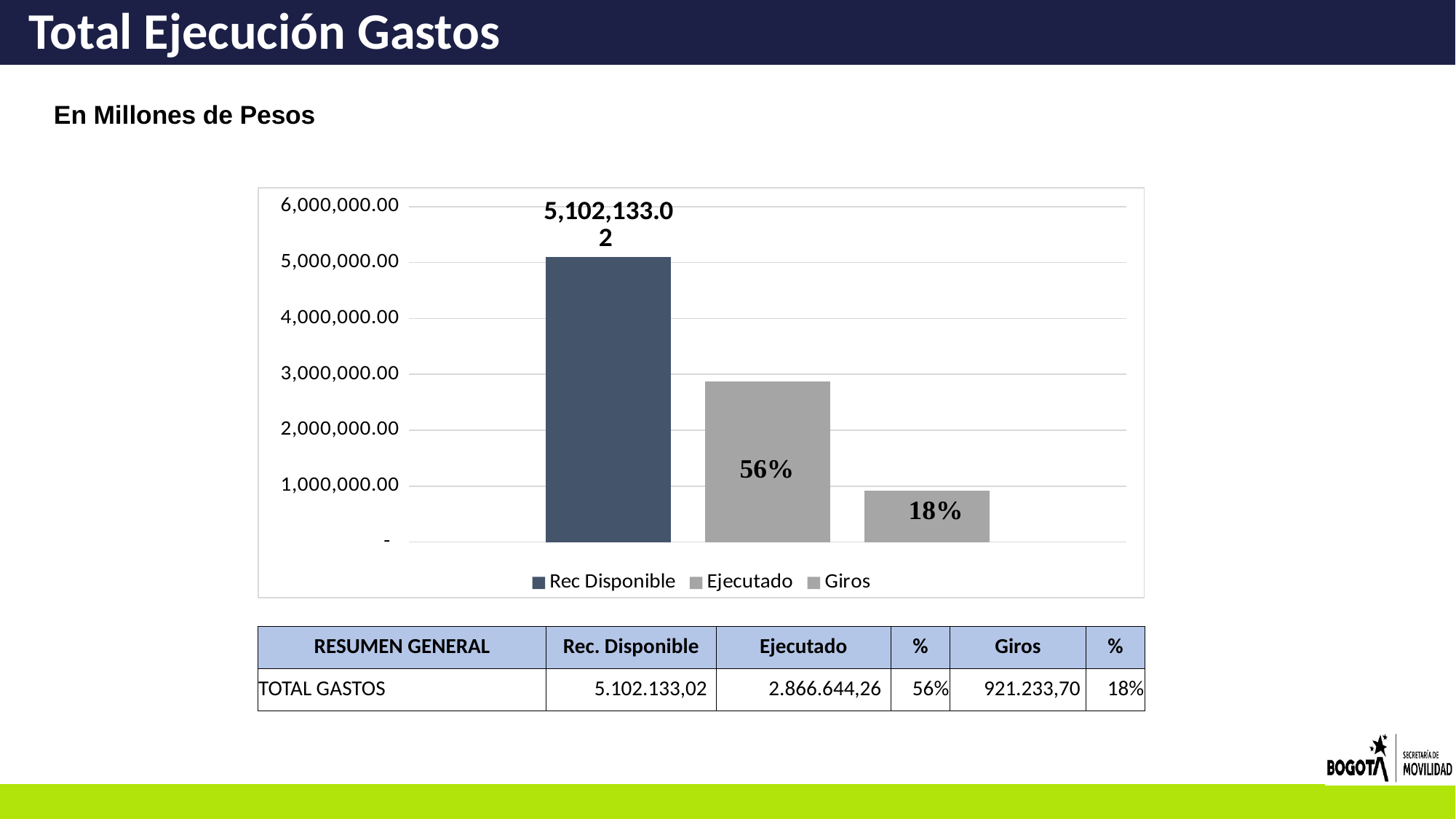
What type of chart is shown on the slide? bar chart Which bar is taller, Ejecutado or Giros? Ejecutado What value is labelled on the Rec Disponible bar? 5,102,133.02 Which series has the tallest bar in the chart? Rec Disponible Which series has the shortest bar in the chart? Giros Which legend entry is shown in dark blue? Rec Disponible Is the value for Ejecutado greater or less than 3,000,000.00? less What percentage label is shown on the Giros bar? 18% How many bars are plotted in the chart? 3 What percentage label is shown on the Ejecutado bar? 56% How many series does the chart legend list? 3 Is the value for Giros greater or less than 1,000,000.00? less